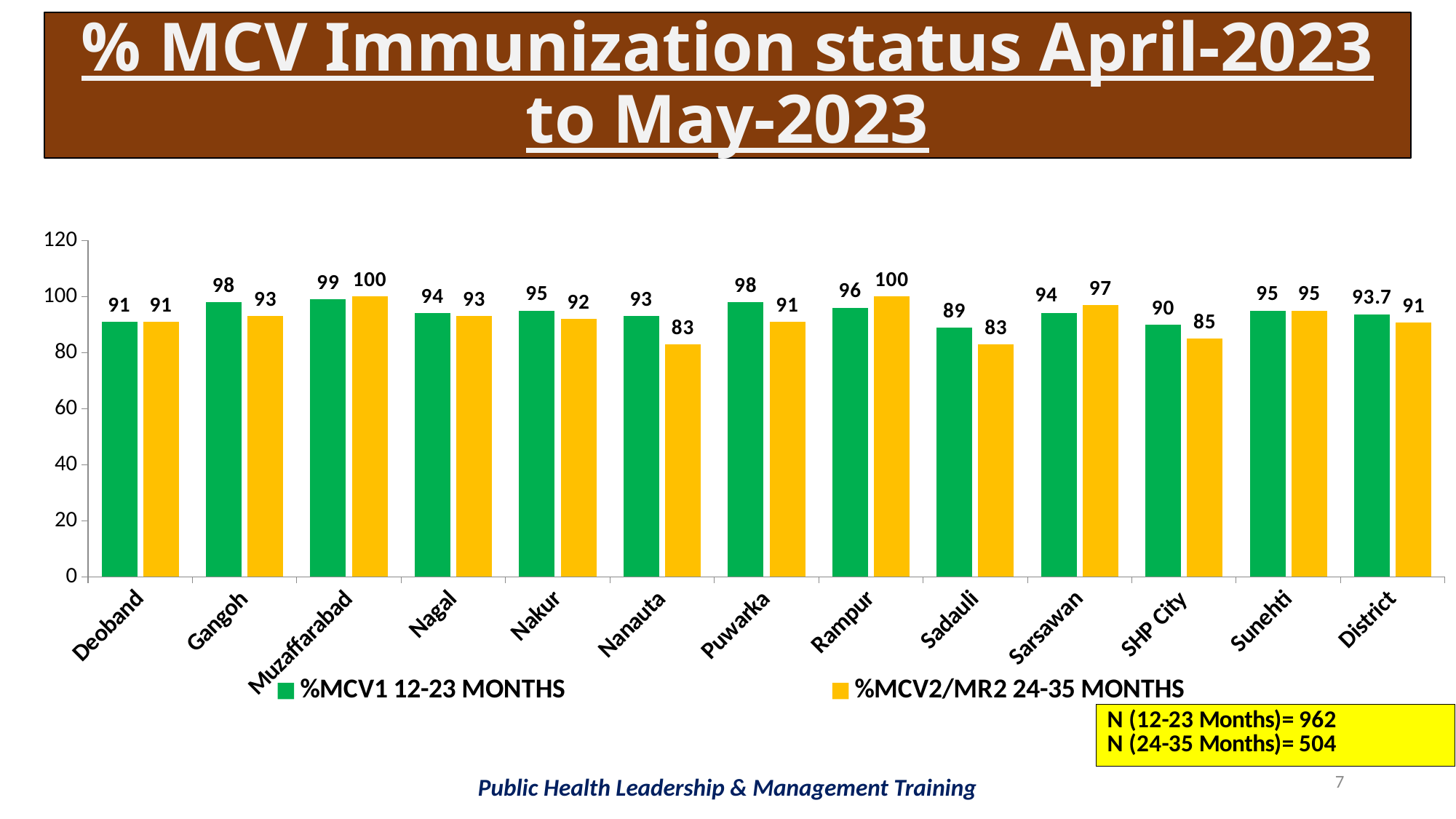
Is the %MCV2/MR2 24-35 MONTHS value for SHP City greater or less than 80? greater What is the difference between the %MCV1 12-23 MONTHS and %MCV2/MR2 24-35 MONTHS values for Nanauta? 10 Which is larger for Rampur: the %MCV1 12-23 MONTHS value or the %MCV2/MR2 24-35 MONTHS value? %MCV2/MR2 24-35 MONTHS What is the %MCV1 12-23 MONTHS value for Muzaffarabad? 99 What is the %MCV2/MR2 24-35 MONTHS value for Nanauta? 83 What colour are the bars for the %MCV2/MR2 24-35 MONTHS series? yellow How many series does the legend list? 2 What is the %MCV1 12-23 MONTHS value for District? 93.7 Which category has the highest %MCV1 12-23 MONTHS value? Muzaffarabad What kind of chart is shown on the slide? bar chart Which category has the lowest %MCV1 12-23 MONTHS value? Sadauli How many categories are shown on the x axis? 13